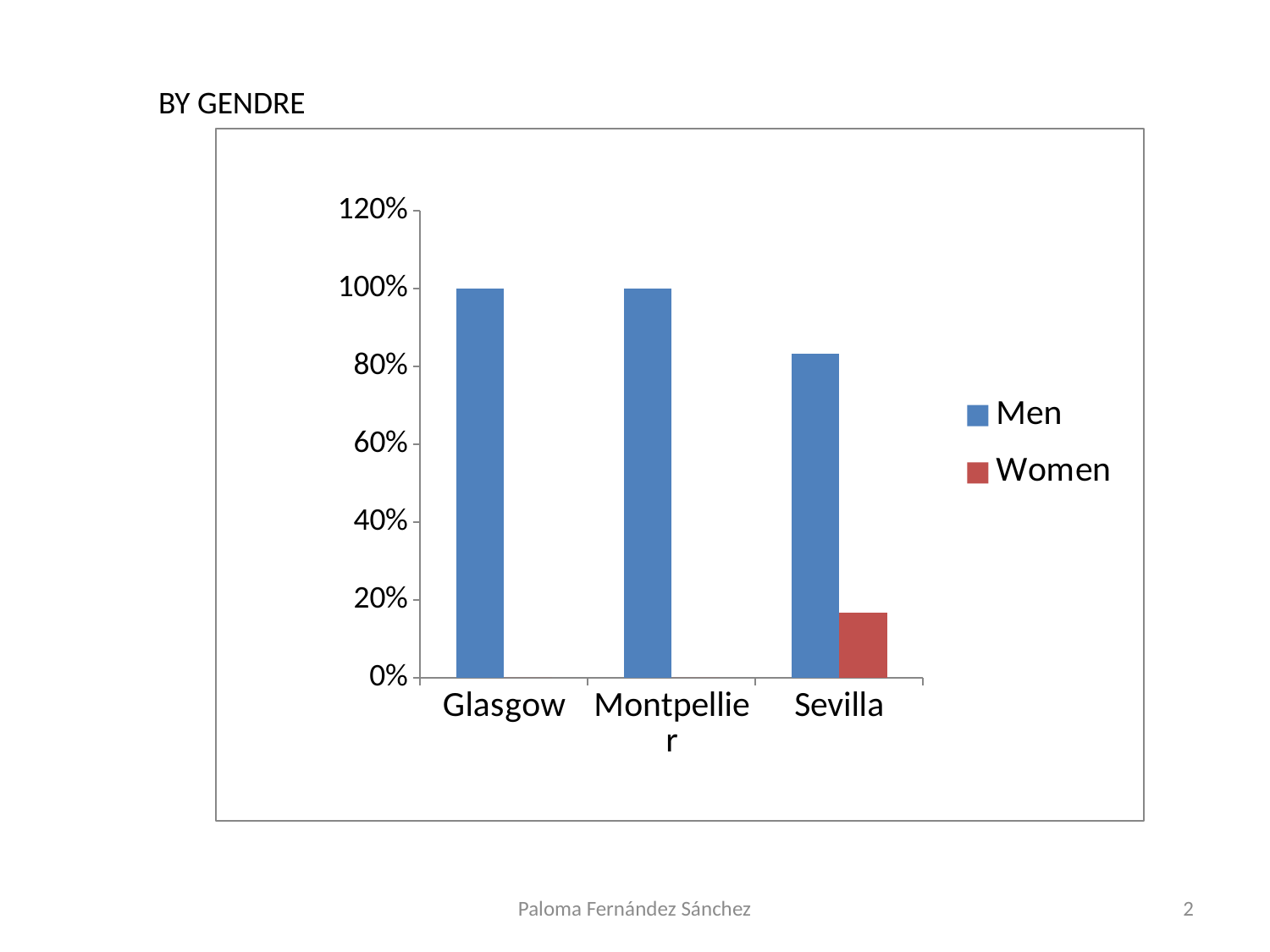
What is the title shown above the chart? BY GENDRE Which city has the highest value for Women? Sevilla What is the value for Men in Glasgow? 100% How many categories are shown on the x axis of the chart? 3 What are the two series listed in the chart's legend? Men and Women How many series does the chart's legend list? 2 In Sevilla, which is larger, the value for Men or the value for Women? Men Which city has the lowest value for Men? Sevilla Is the value for Women in Sevilla greater or less than 20%? less Is the value for Men in Sevilla greater or less than 100%? less What type of chart is shown on the slide? bar chart What is the value for Men in Montpellier? 100%